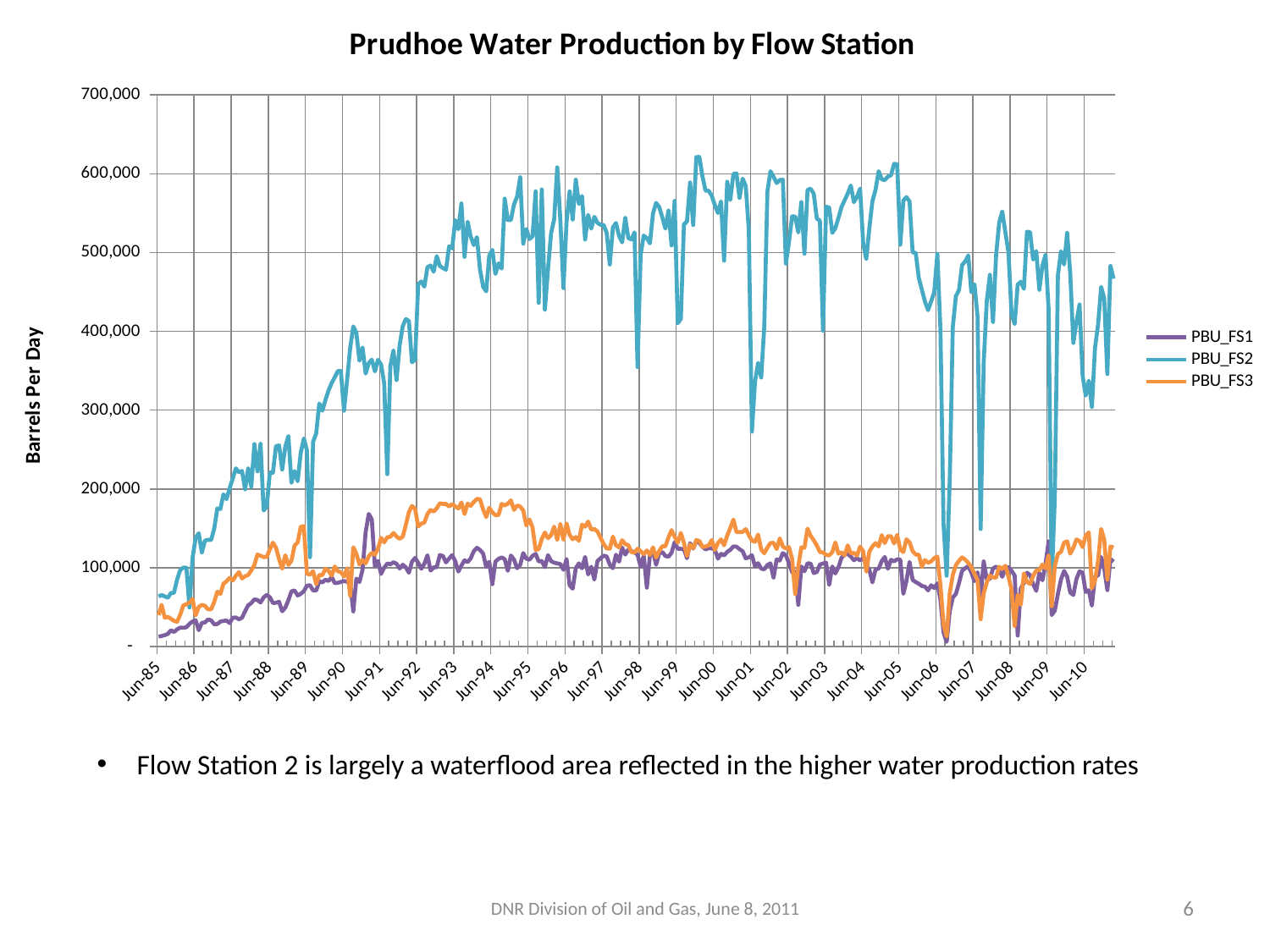
Is the value for PBU_FS2 at Jun-00 greater or less than 500,000? greater At Jun-93, which is larger, PBU_FS2 or PBU_FS3? PBU_FS2 Does PBU_FS2 rise or fall between Jun-85 and Jun-93? rise How many series does the legend list? 3 Is the value for PBU_FS2 at Jun-85 greater or less than 100,000? less At Jun-88, which is larger, PBU_FS3 or PBU_FS1? PBU_FS3 What kind of chart is shown on the slide? Line chart Is the value for PBU_FS1 at Jun-85 greater or less than 100,000? less Which series has the highest water production across most of the chart? PBU_FS2 What is the title of the chart? Prudhoe Water Production by Flow Station What is the label on the vertical axis? Barrels Per Day